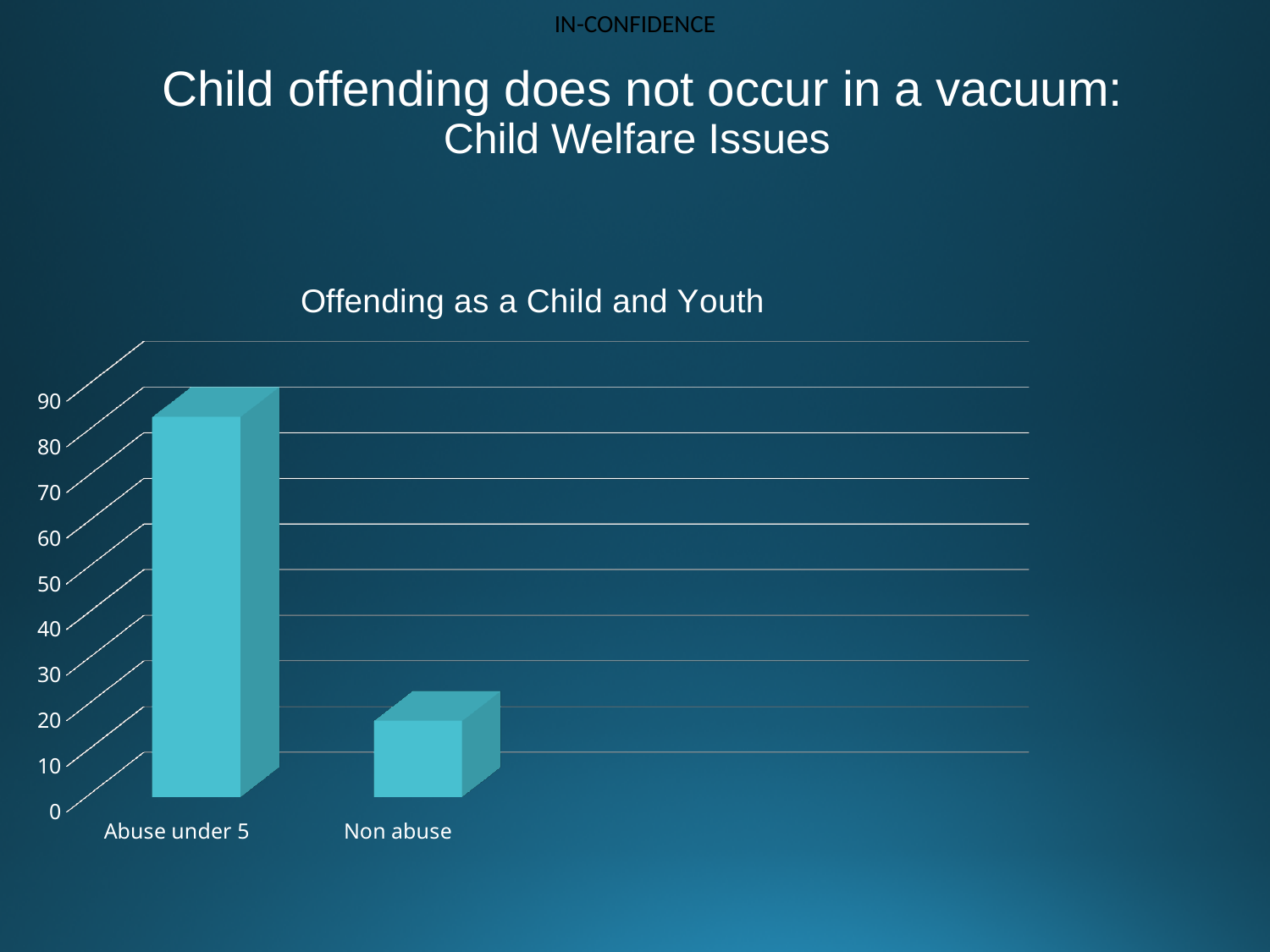
Is the value for Abuse under 5 greater or less than 70? greater Is the value for Non abuse greater or less than 40? less Which category has the lowest value in the chart? Non abuse Is the value for Abuse under 5 greater or less than 50? greater What type of chart is shown on the slide? Bar chart What is the highest value labelled on the vertical axis of the chart? 90 Which is larger, the value for Abuse under 5 or the value for Non abuse? Abuse under 5 Which category has the highest value in the chart? Abuse under 5 What is the title of the chart? Offending as a Child and Youth How many categories are plotted in the chart? 2